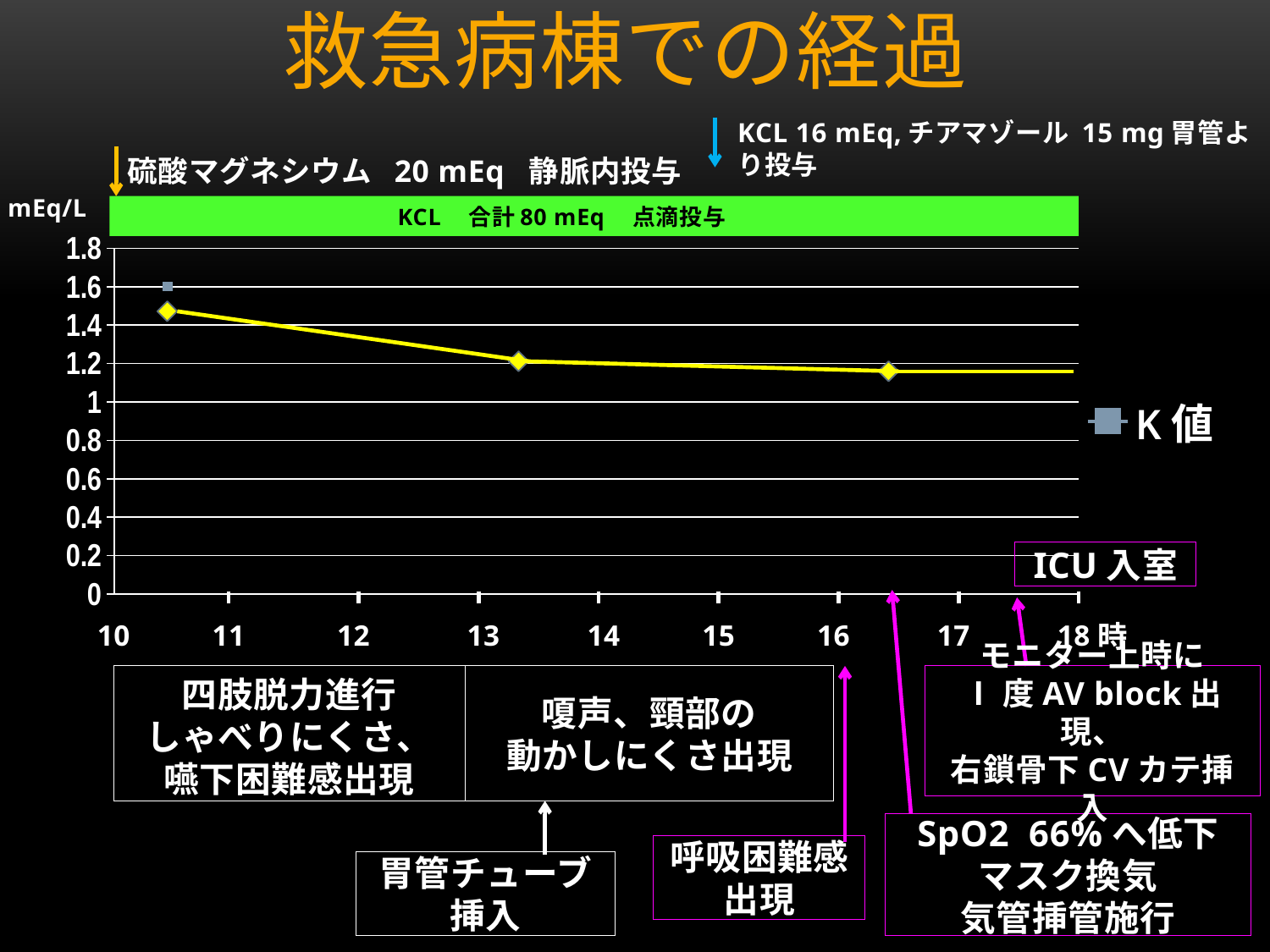
Which is larger, the first plotted K値 value or the last plotted K値 value? the first Is the last plotted K値 value (around 16時) greater or less than 1? greater Which plotted point has the highest K値: the first, second, or third? the first What is the title of the slide containing the chart? 救急病棟での経過 What is the name of the series shown in the legend? K値 How many data points are plotted on the line? 3 Is the first plotted K値 value (around 10時) greater or less than 1.4? greater Do the plotted K値 values rise or fall from left to right along the x axis? fall How many series does the legend list? 1 Is the last plotted K値 value (around 16時) greater or less than 1.4? less What kind of chart is shown on the slide? line chart